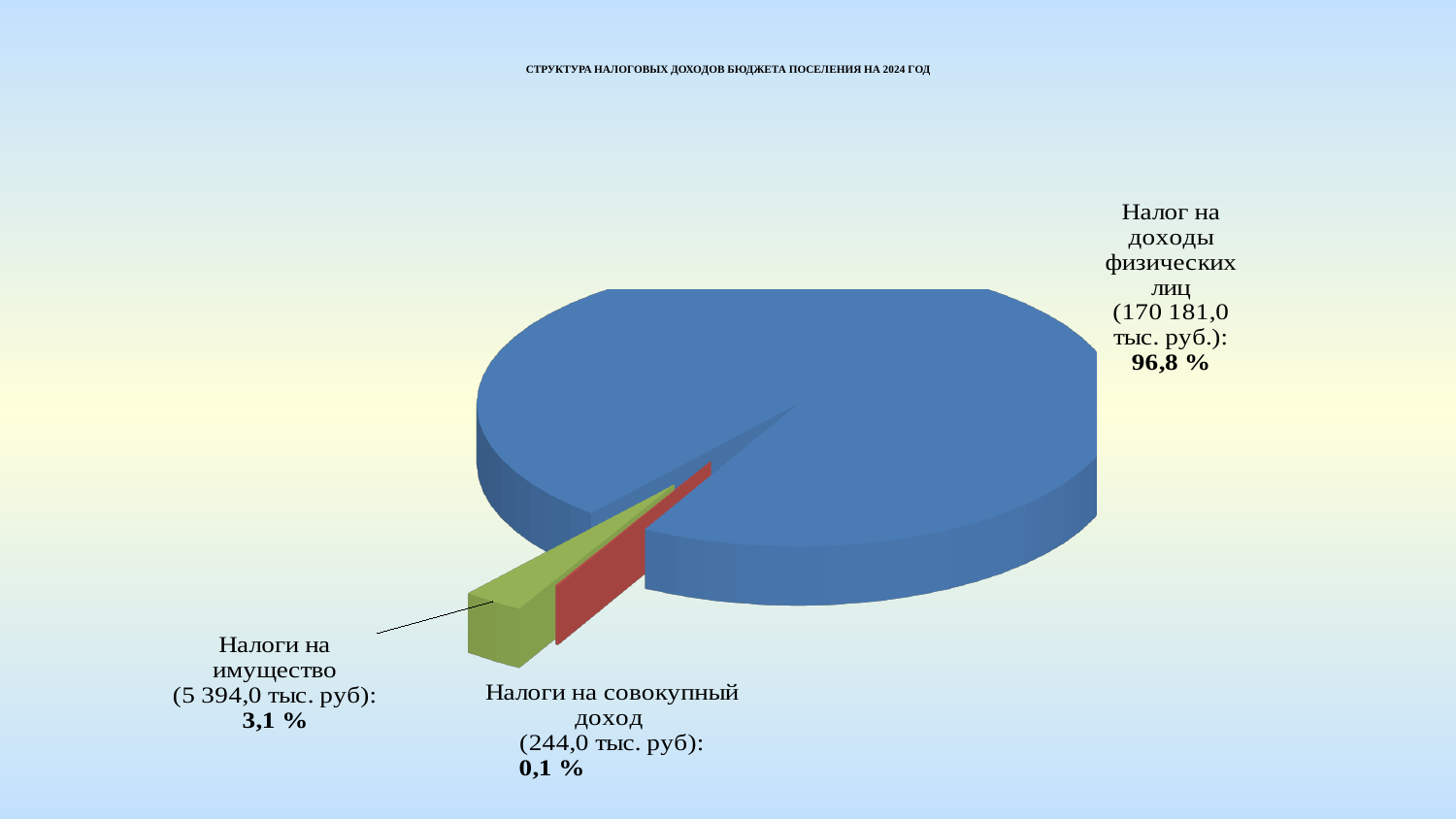
Какова доля налогов на совокупный доход в структуре налоговых доходов? 0,1 % Какая сумма налогов на имущество указана на диаграмме? 5 394,0 тыс. руб. Какой тип диаграммы показан на слайде? Круговая диаграмма Какая категория имеет наименьшую долю в структуре налоговых доходов? Налоги на совокупный доход Сколько категорий (секторов) показано на круговой диаграмме? 3 Какая сумма налога на доходы физических лиц указана на диаграмме? 170 181,0 тыс. руб. Какая категория имеет наибольшую долю в структуре налоговых доходов? Налог на доходы физических лиц Какая сумма налогов на совокупный доход указана на диаграмме? 244,0 тыс. руб. На сколько процентных пунктов доля налога на доходы физических лиц больше доли налогов на имущество? 93,7 процентных пункта Какова доля налогов на имущество в структуре налоговых доходов? 3,1 % Какова доля налога на доходы физических лиц в структуре налоговых доходов? 96,8 % Что больше: налоги на имущество или налоги на совокупный доход? Налоги на имущество